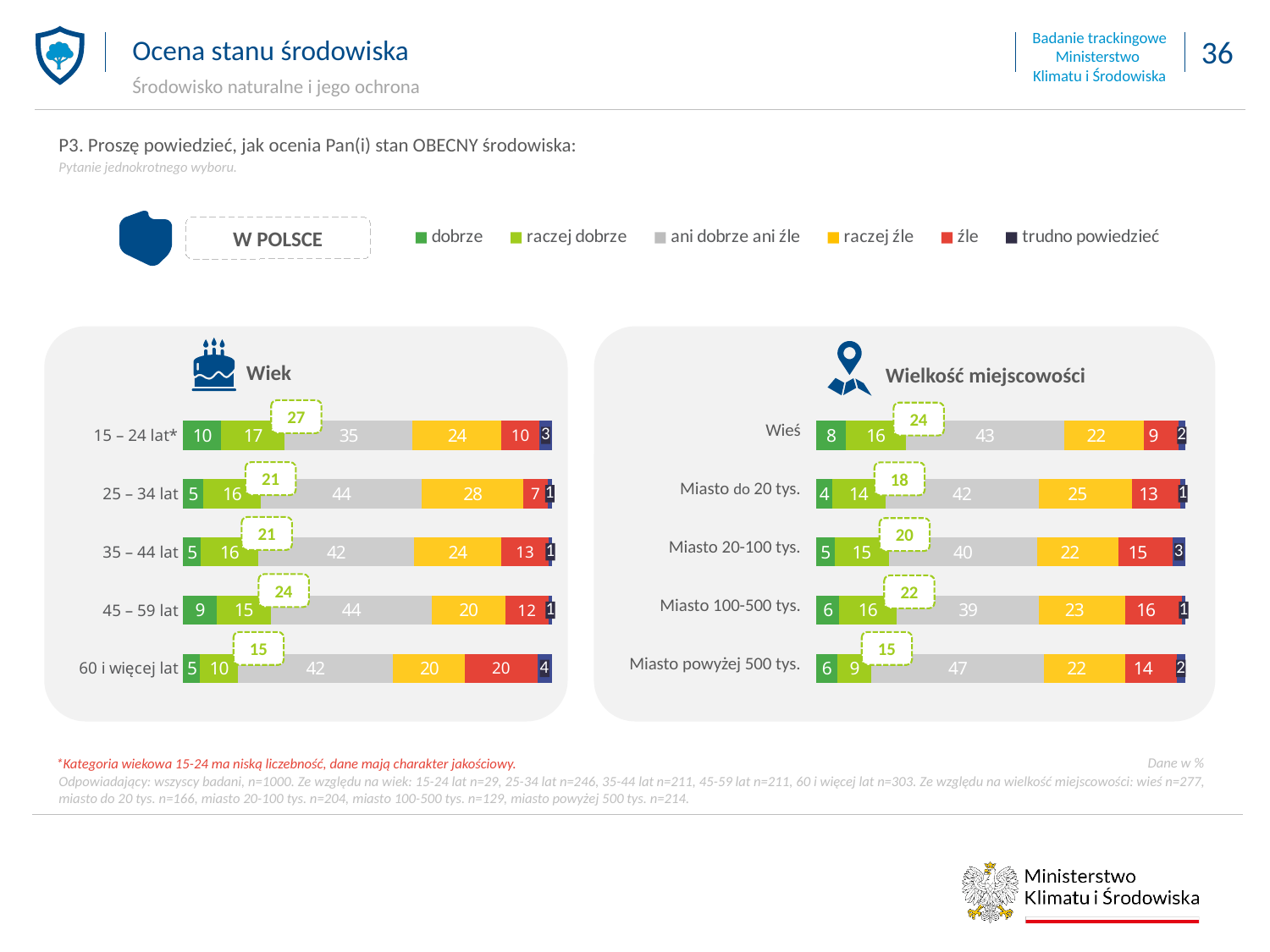
In the "Wielkość miejscowości" chart, what is the value for "dobrze" for Wieś? 8 In the "Wiek" chart, what is the value for "ani dobrze ani źle" in the 25 – 34 lat category? 44 What kind of chart is the "Wielkość miejscowości" chart? Stacked bar chart How many series does the legend list? 6 In the "Wielkość miejscowości" chart, what is the combined "dobrze" and "raczej dobrze" value shown in the callout for Miasto 20-100 tys.? 20 How many categories are shown in the "Wiek" chart? 5 In the "Wielkość miejscowości" chart, which is larger: the "ani dobrze ani źle" value for Wieś or for Miasto 100-500 tys.? Wieś In the "Wielkość miejscowości" chart, which category has the lowest value for "raczej dobrze"? Miasto powyżej 500 tys. In the "Wiek" chart, which age category has the highest value for "dobrze"? 15 – 24 lat* In the "Wiek" chart, what is the difference between the "raczej źle" values for 25 – 34 lat and 45 – 59 lat? 8 In the "Wiek" chart, what is the value for "źle" in the 60 i więcej lat category? 20 In the "Wielkość miejscowości" chart, what is the value for "raczej źle" for Miasto do 20 tys.? 25